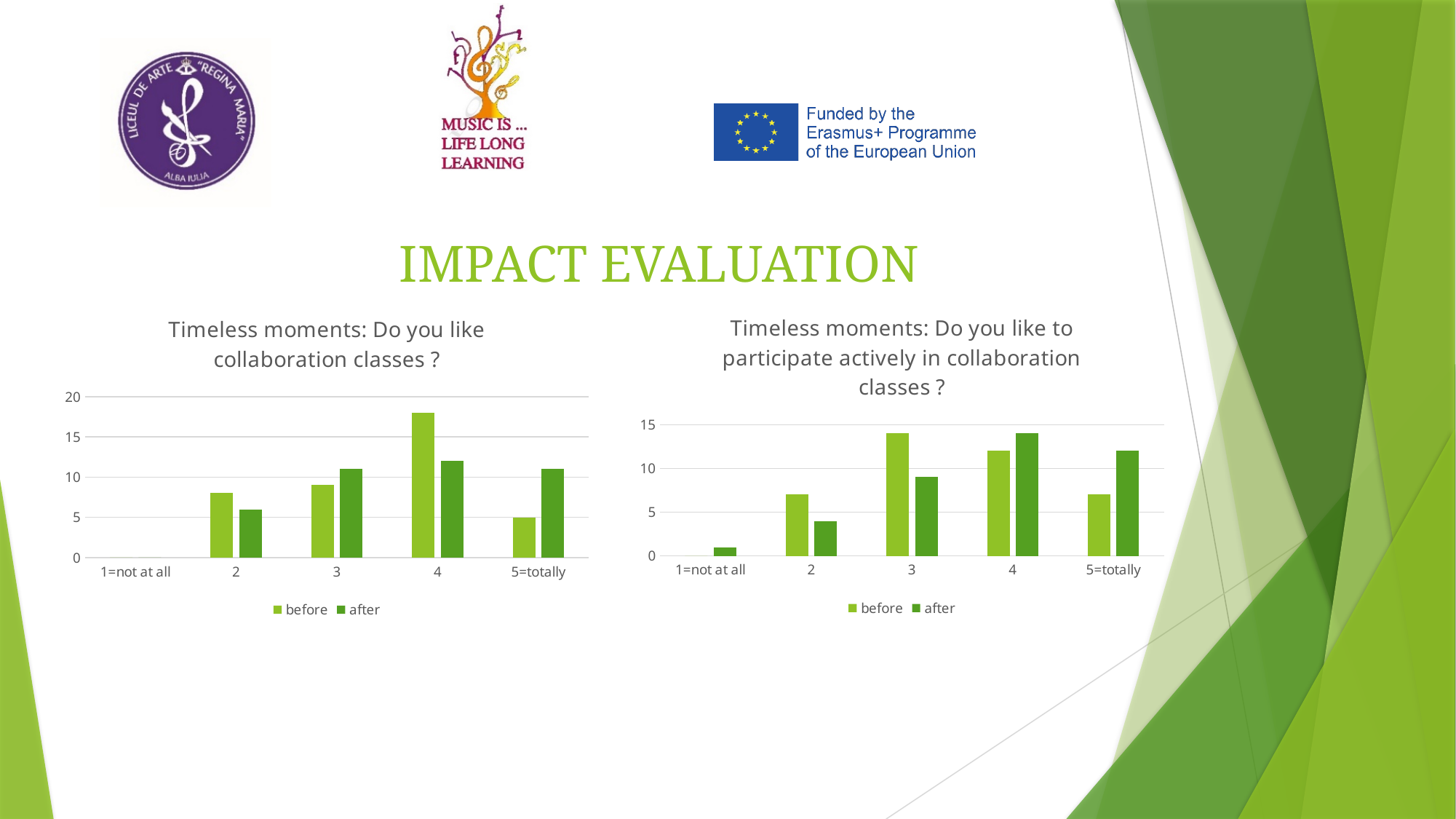
What are the two legend entries in the right chart ("Do you like to participate actively in collaboration classes ?")? before, after In the right chart ("Do you like to participate actively in collaboration classes ?"), for "5=totally", which is larger: "before" or "after"? after In the left chart ("Do you like collaboration classes ?"), is the "before" value for category 2 greater or less than 10? less How many categories are shown on the x axis of the left chart ("Do you like collaboration classes ?")? 5 In the left chart ("Do you like collaboration classes ?"), for category 4, which is larger: "before" or "after"? before In the right chart ("Do you like to participate actively in collaboration classes ?"), is the "after" value for category 2 greater or less than 5? less In the left chart ("Do you like collaboration classes ?"), how many series does the legend list? 2 In the left chart ("Do you like collaboration classes ?"), which category has the tallest "before" bar? 4 In the right chart ("Do you like to participate actively in collaboration classes ?"), is the "before" value for category 3 greater or less than 10? greater What kind of chart is the left chart titled "Timeless moments: Do you like collaboration classes ?"? bar chart In the right chart ("Do you like to participate actively in collaboration classes ?"), which category has the tallest "after" bar? 4